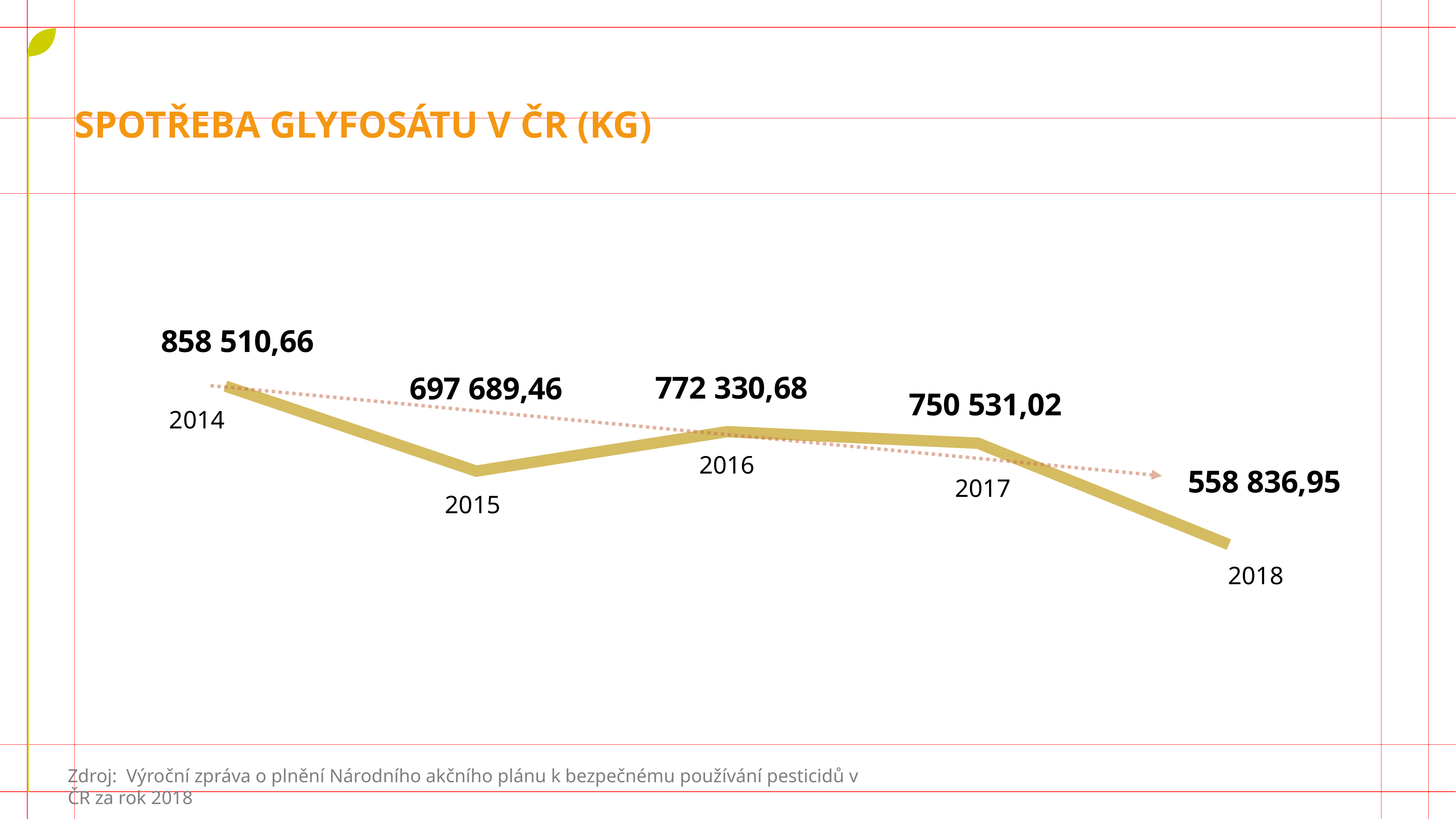
Which year has the highest value? 2014 What kind of chart is shown on the slide? Line chart How many years are plotted on the chart? 5 What value is shown for 2018? 558 836,95 Which year has the larger value, 2015 or 2017? 2017 What is the overall trend of the values from 2014 to 2018? Falling What value is shown for 2016? 772 330,68 Which year has the lowest value? 2018 What is the title of the chart? SPOTŘEBA GLYFOSÁTU V ČR (KG) What is the difference between the 2016 value and the 2015 value? 74 641,22 What is the difference between the 2014 value and the 2018 value? 299 673,71 What is the glyphosate consumption value shown for 2014? 858 510,66